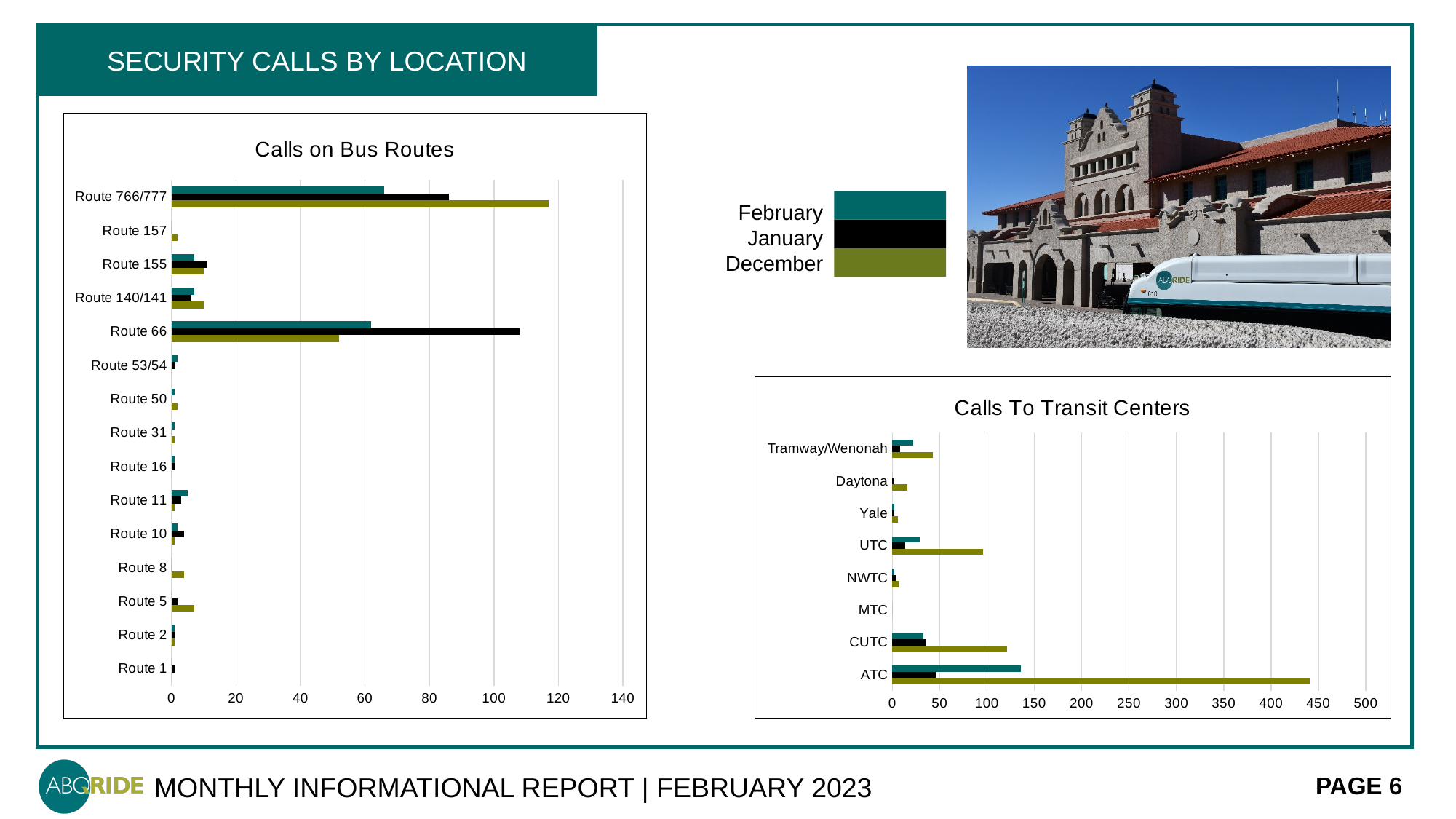
On the "Calls To Transit Centers" chart, which is larger: the December value for CUTC or the December value for UTC? CUTC On the "Calls on Bus Routes" chart, which is larger: the January value for Route 66 or the January value for Route 766/777? Route 66 How many series does the legend list for the charts? 3 On the "Calls To Transit Centers" chart, is the December value for ATC greater or less than 400? greater Which months does the legend list? February, January, December On the "Calls To Transit Centers" chart, which transit center has the highest December value? ATC On the "Calls on Bus Routes" chart, is the January value for Route 66 greater or less than 100? greater How many transit centers are listed on the "Calls To Transit Centers" chart? 8 On the "Calls on Bus Routes" chart, which route has the highest December value? Route 766/777 How many bus routes are listed on the "Calls on Bus Routes" chart? 15 On the "Calls To Transit Centers" chart, is the February value for ATC greater or less than 100? greater What kind of chart is the "Calls on Bus Routes" chart? bar chart